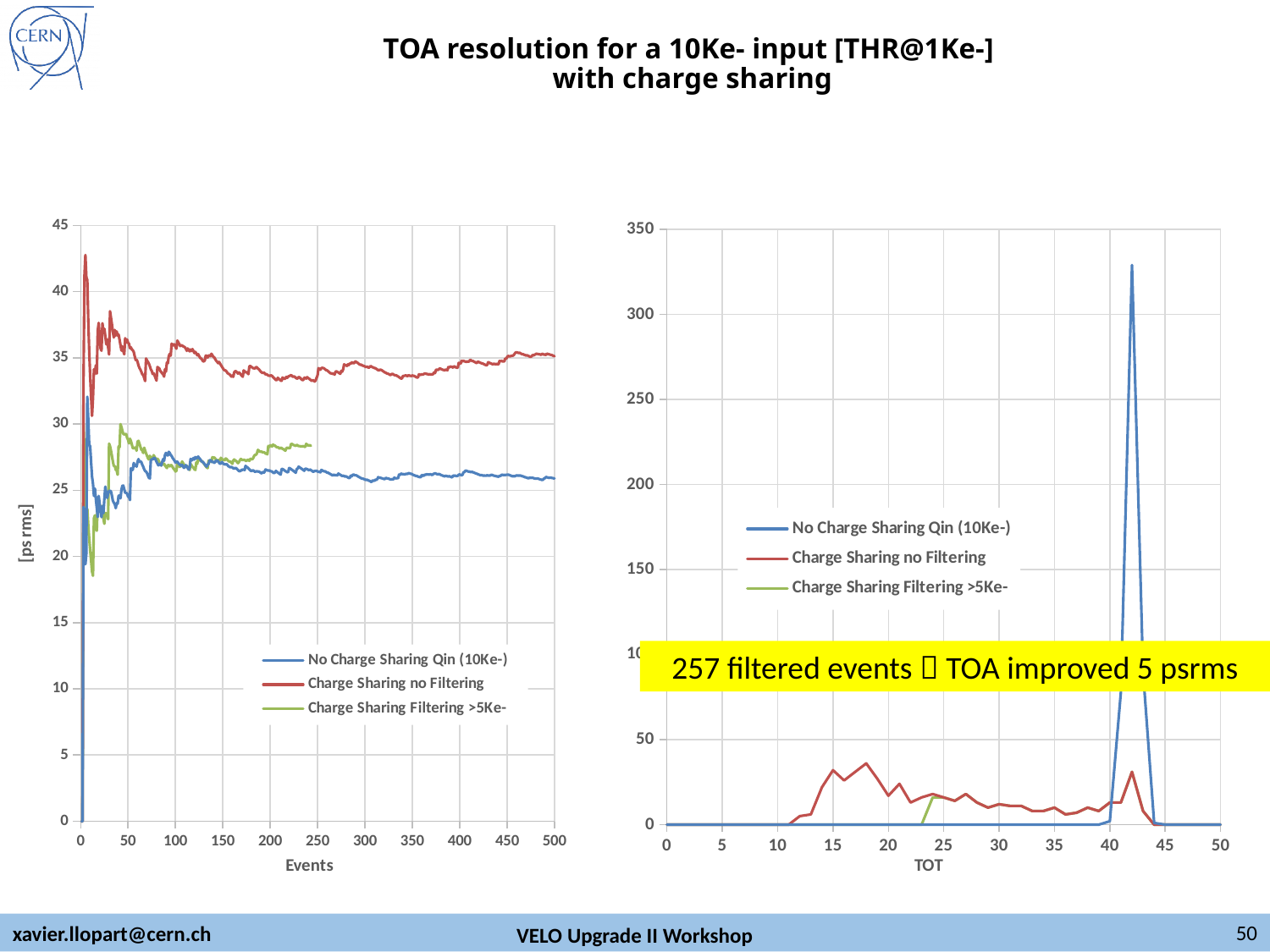
What kind of chart is the left chart (with x axis 'Events')? line chart How many series does the legend of the left chart list? 3 On the right chart, which series reaches the highest peak? No Charge Sharing Qin (10Ke-) On the right chart, what is the label of the x axis? TOT On the right chart, is the peak value of 'No Charge Sharing Qin (10Ke-)' greater or less than 300? greater What kind of chart is the right chart (with x axis 'TOT')? line chart On the right chart, is the peak value of 'Charge Sharing no Filtering' greater or less than 50? less On the left chart, is the value of 'No Charge Sharing Qin (10Ke-)' at 500 events greater or less than 30? less How many series does the legend of the right chart list? 3 On the left chart, which series has the larger value at 500 events: 'Charge Sharing no Filtering' or 'No Charge Sharing Qin (10Ke-)'? Charge Sharing no Filtering On the left chart, what is the label of the y axis? [ps rms]